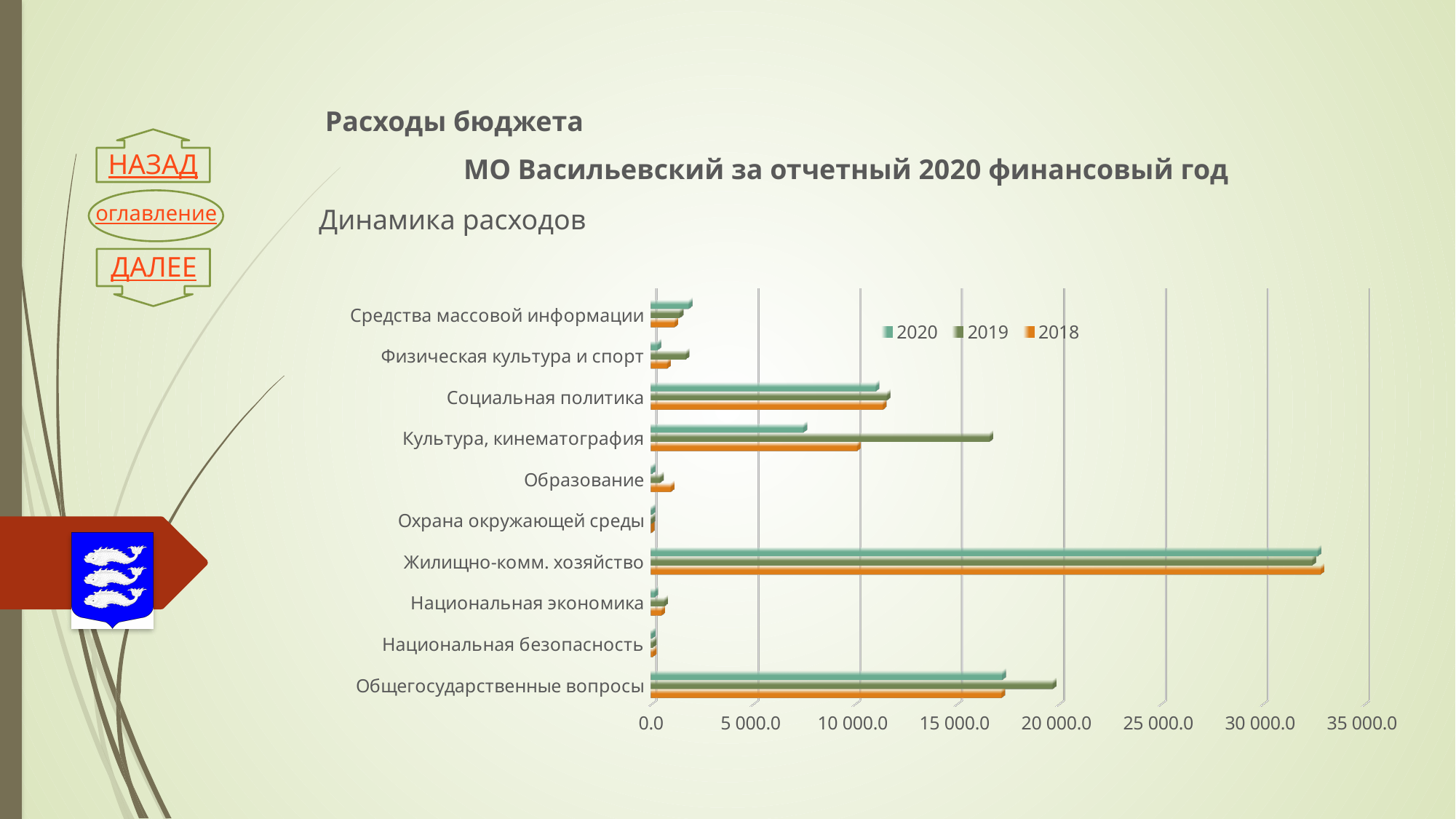
Which category has the highest value for 2020? Жилищно-комм. хозяйство What kind of chart is shown on the slide? bar chart For Культура, кинематография, which year has the larger value: 2019 or 2020? 2019 Which years are listed in the chart legend? 2020, 2019, 2018 How many series does the legend of the chart list? 3 Is the 2019 value for Общегосударственные вопросы greater or less than 15 000.0? greater Is the 2020 value for Жилищно-комм. хозяйство greater or less than 30 000.0? greater Is the 2020 value for Культура, кинематография greater or less than 10 000.0? less Which category has the highest value for 2018? Жилищно-комм. хозяйство For Общегосударственные вопросы, which year has the larger value: 2019 or 2020? 2019 How many expenditure categories are shown on the chart? 10